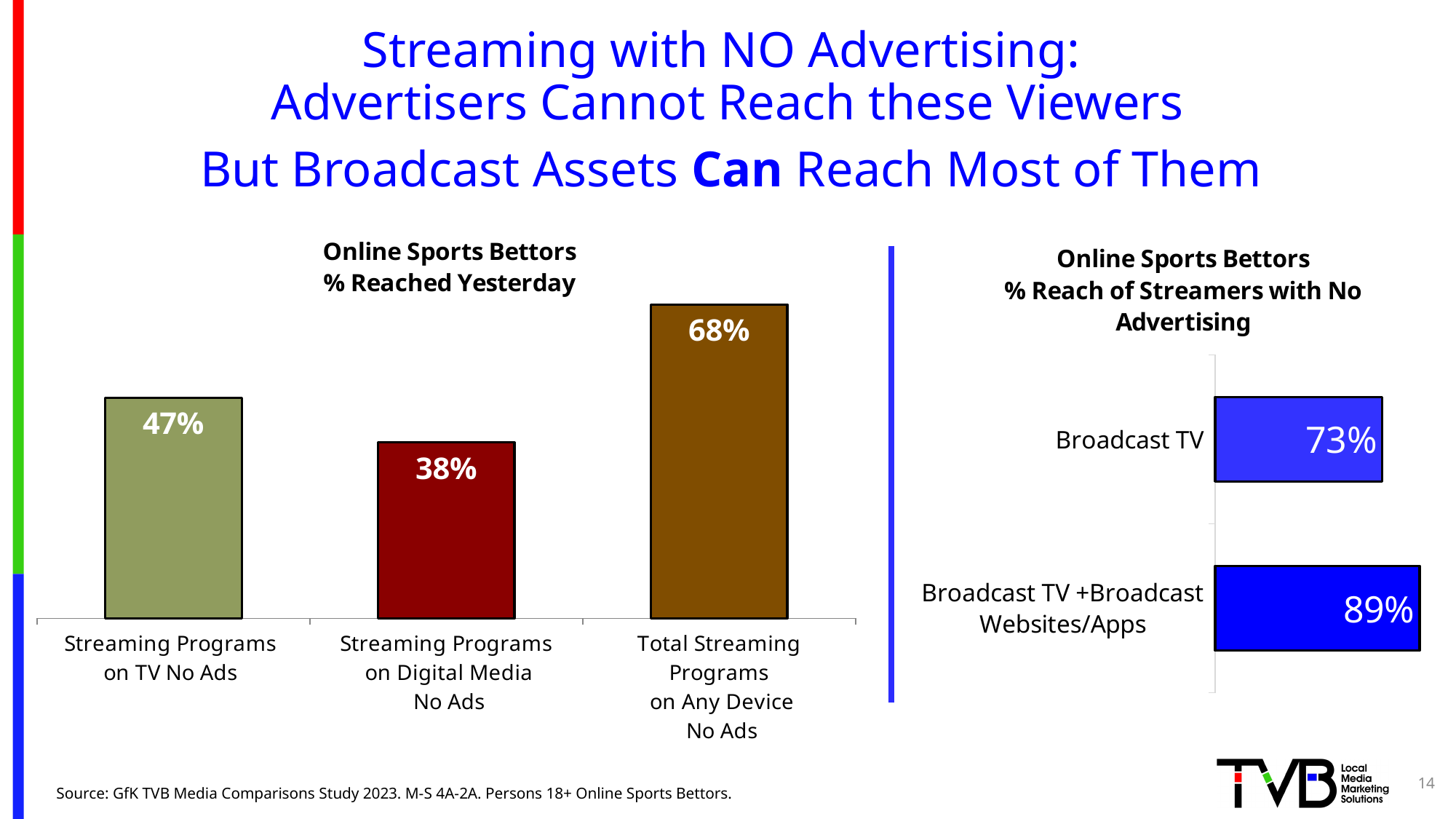
In the left chart titled 'Online Sports Bettors % Reached Yesterday', what is the value for Streaming Programs on Digital Media No Ads? 38% In the left chart titled 'Online Sports Bettors % Reached Yesterday', how many categories are shown? 3 In the right chart titled 'Online Sports Bettors % Reach of Streamers with No Advertising', which is larger: Broadcast TV or Broadcast TV + Broadcast Websites/Apps? Broadcast TV + Broadcast Websites/Apps In the left chart titled 'Online Sports Bettors % Reached Yesterday', which category has the highest value? Total Streaming Programs on Any Device No Ads In the right chart titled 'Online Sports Bettors % Reach of Streamers with No Advertising', how many categories are shown? 2 In the left chart titled 'Online Sports Bettors % Reached Yesterday', what is the value for Streaming Programs on TV No Ads? 47% In the right chart titled 'Online Sports Bettors % Reach of Streamers with No Advertising', what is the value for Broadcast TV? 73% In the right chart titled 'Online Sports Bettors % Reach of Streamers with No Advertising', what is the value for Broadcast TV + Broadcast Websites/Apps? 89% In the right chart titled 'Online Sports Bettors % Reach of Streamers with No Advertising', what is the difference between Broadcast TV + Broadcast Websites/Apps and Broadcast TV? 16% In the left chart titled 'Online Sports Bettors % Reached Yesterday', what is the difference between Total Streaming Programs on Any Device No Ads and Streaming Programs on TV No Ads? 21% What kind of chart is the right chart titled 'Online Sports Bettors % Reach of Streamers with No Advertising'? Bar chart In the left chart titled 'Online Sports Bettors % Reached Yesterday', which category has the lowest value? Streaming Programs on Digital Media No Ads